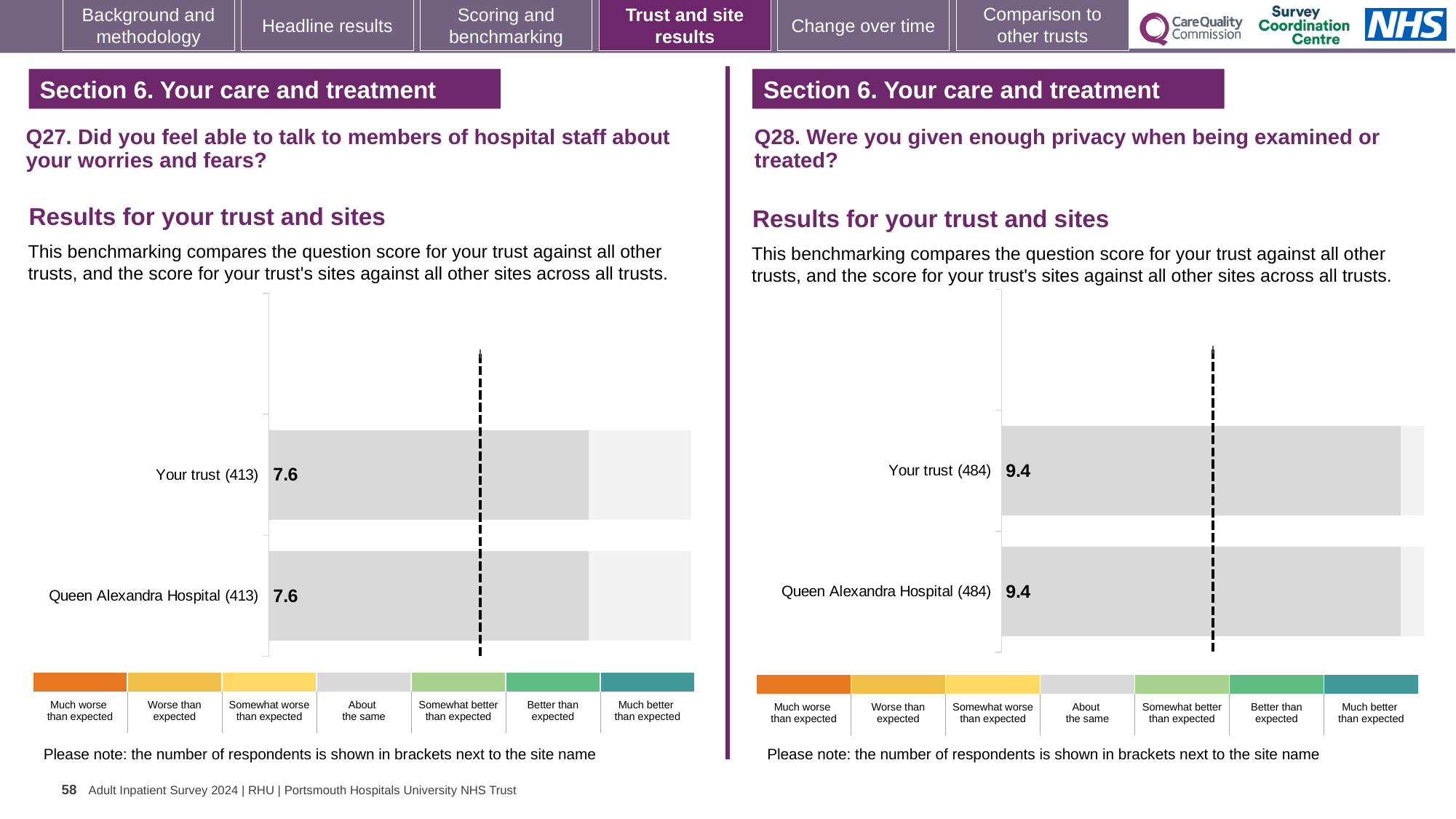
On the Q27 chart (left), what is the score for Queen Alexandra Hospital? 7.6 On the Q28 chart (right), what is the score for Queen Alexandra Hospital? 9.4 On the Q27 chart (left), how many respondents are shown in brackets for Your trust? 413 How many bars are plotted on the Q28 chart (right)? 2 On the Q28 chart (right), how many respondents are shown in brackets for Queen Alexandra Hospital? 484 On the Q28 chart (right), what is the score for Your trust? 9.4 On the Q27 chart (left), what is the difference between the Your trust score and the Queen Alexandra Hospital score? 0.0 On the Q27 chart (left), what is the score for Your trust? 7.6 What kind of chart is the Q27 chart (left)? Bar chart How many bars are plotted on the Q27 chart (left)? 2 On the Q28 chart (right), what is the difference between the Your trust score and the Queen Alexandra Hospital score? 0.0 Is the Your trust score on the Q28 chart (right) larger or smaller than the Your trust score on the Q27 chart (left)? Larger